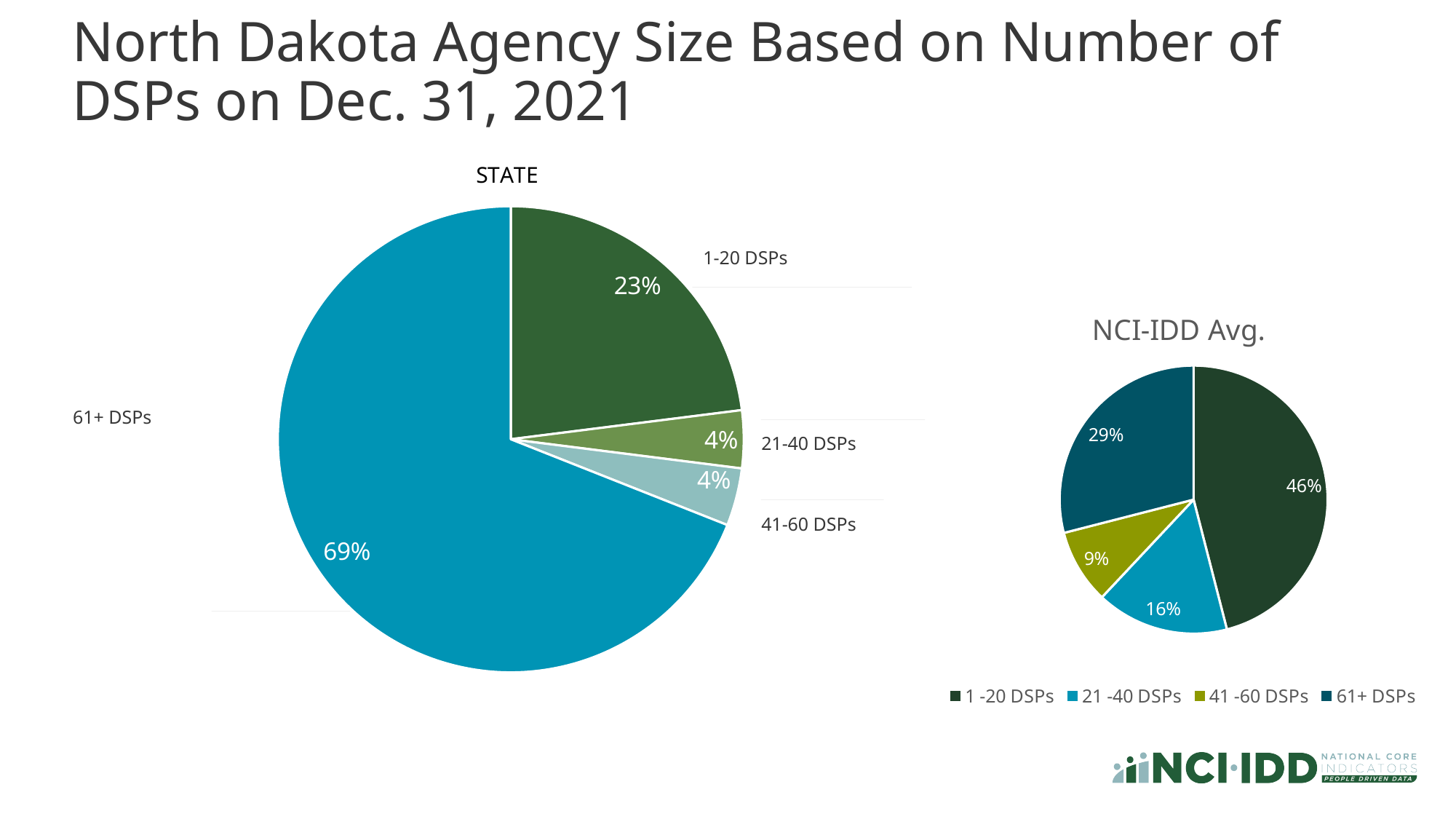
In the NCI-IDD Avg. pie chart, which agency size category has the smallest share? 41-60 DSPs In the STATE pie chart, what percentage of agencies have 1-20 DSPs? 23% In the NCI-IDD Avg. pie chart, what percentage of agencies have 61+ DSPs? 29% In the NCI-IDD Avg. pie chart, what percentage of agencies have 41-60 DSPs? 9% What type of chart is used for the NCI-IDD Avg. data? Pie chart How many categories does the STATE pie chart show? 4 In the STATE pie chart, which agency size category has the largest share? 61+ DSPs In the NCI-IDD Avg. pie chart, what percentage of agencies have 1-20 DSPs? 46% What is the difference between the 61+ DSPs share in the STATE chart and the 61+ DSPs share in the NCI-IDD Avg. chart? 40 percentage points In the STATE pie chart, what percentage of agencies have 61+ DSPs? 69% Is the share of agencies with 1-20 DSPs larger in the STATE chart or in the NCI-IDD Avg. chart? NCI-IDD Avg. In the STATE pie chart, what percentage of agencies have 21-40 DSPs? 4%